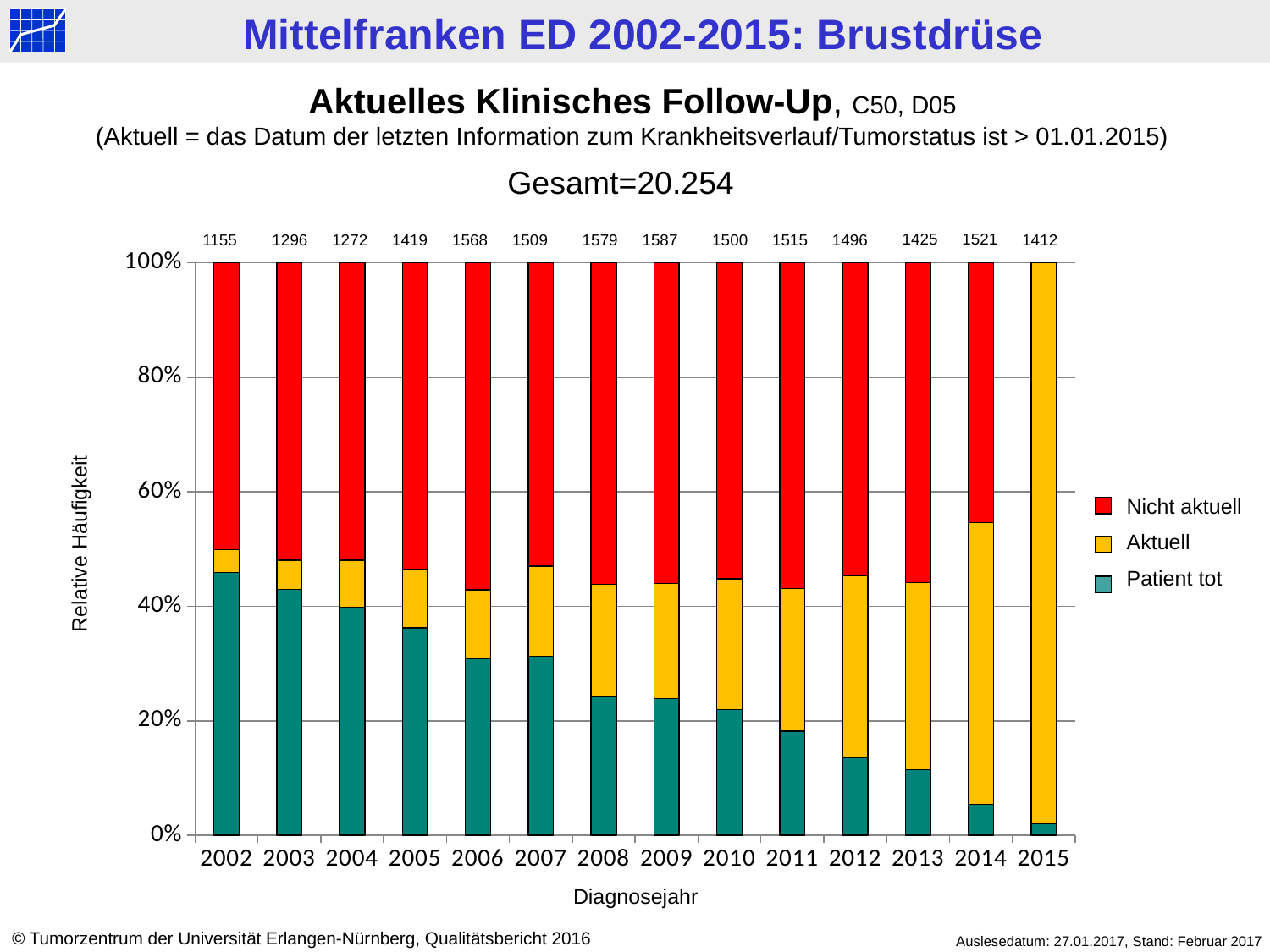
What is the difference between the numbers printed above the bars for 2009 and 2002? 432 How many series does the legend list? 3 Is the 'Patient tot' share for 2015 greater or less than 20%? less What is the title of the x axis? Diagnosejahr What number is printed above the bar for 2002? 1155 Does the 'Patient tot' share rise or fall from 2002 to 2015? fall Which diagnosis year has the highest number printed above its bar? 2009 How many diagnosis years (categories) are shown on the x axis? 14 What kind of chart is shown on the slide? Stacked bar chart What number is printed above the bar for 2009? 1587 Is the 'Patient tot' share for 2002 greater or less than 40%? greater Which diagnosis year has the lowest number printed above its bar? 2002